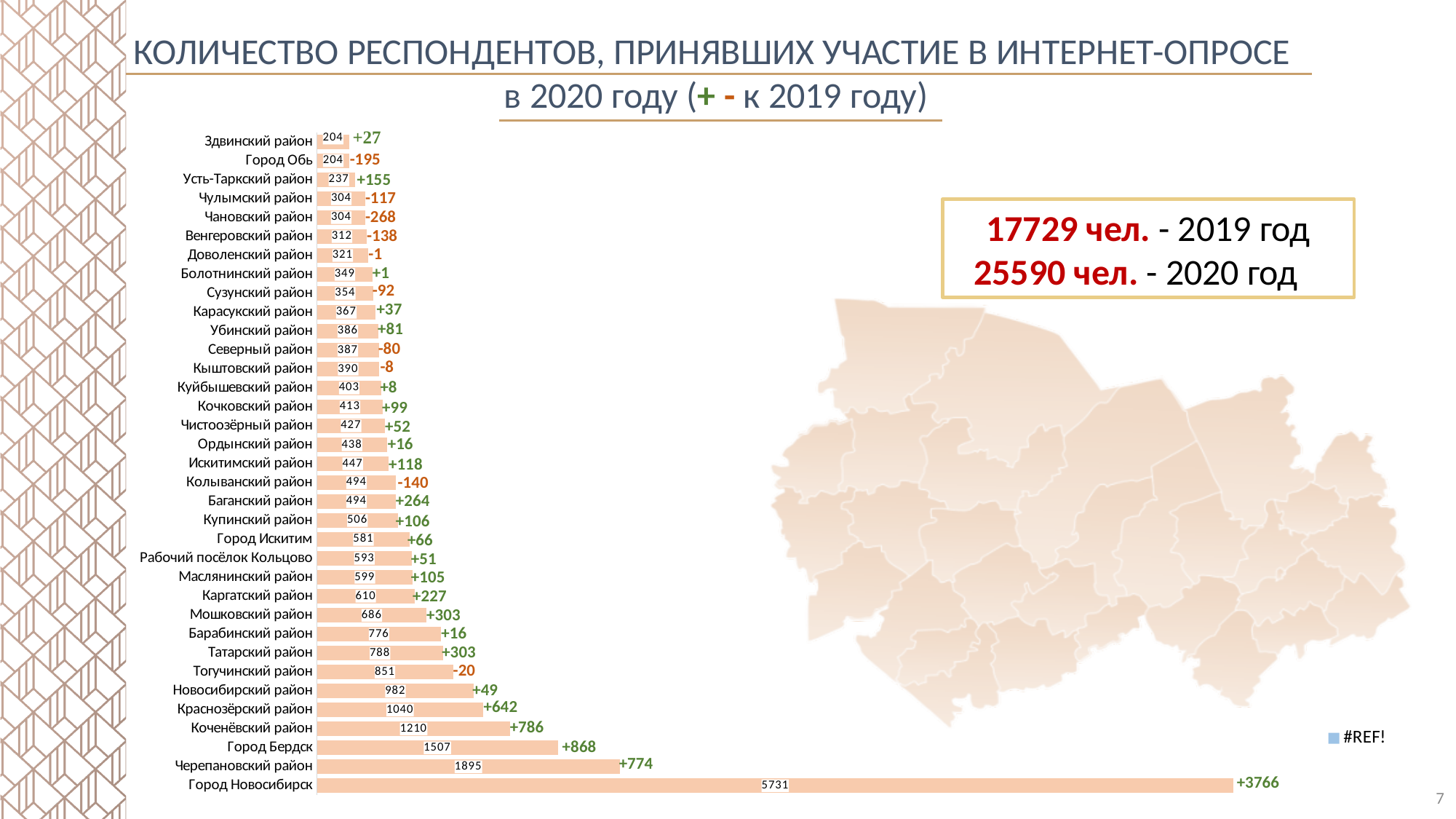
What text appears in the chart legend? #REF! Which category has the highest value? Город Новосибирск What is the difference between the values for Город Новосибирск and Черепановский район? 3836 How many respondents are shown for Город Новосибирск? 5731 What is the value for Рабочий посёлок Кольцово? 593 How many categories are shown on the chart? 35 How many series does the legend list? 1 What is the value for Коченёвский район? 1210 Which is larger, the value for Город Бердск or the value for Коченёвский район? Город Бердск What kind of chart is shown on the slide? bar chart What is the value for Черепановский район? 1895 What is the lowest value shown on the chart? 204